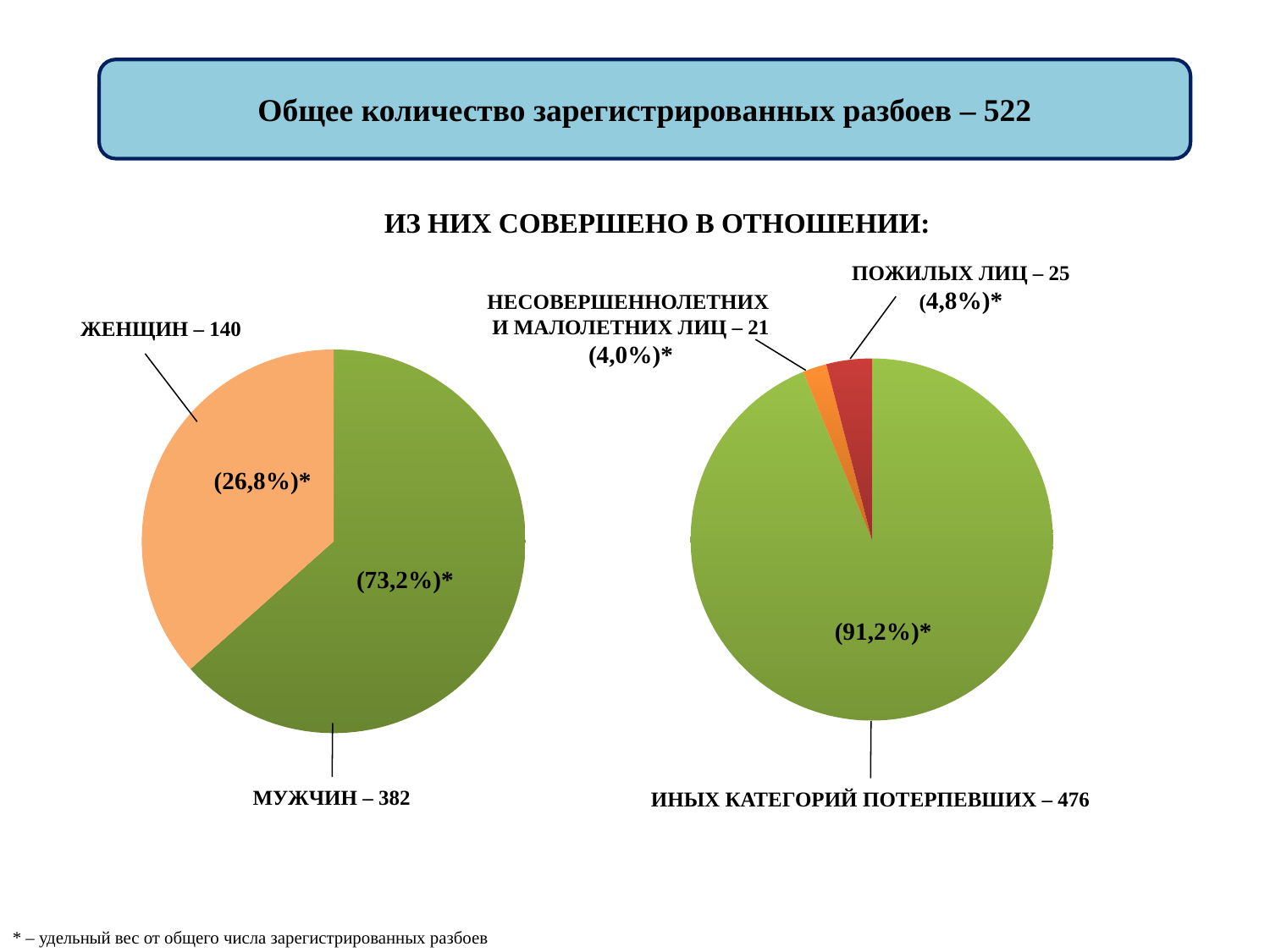
On the right pie chart, what is the value for НЕСОВЕРШЕННОЛЕТНИХ И МАЛОЛЕТНИХ ЛИЦ? 21 How many slices does the right pie chart have? 3 On the right pie chart, which category has the smallest value? НЕСОВЕРШЕННОЛЕТНИХ И МАЛОЛЕТНИХ ЛИЦ What type of chart is the left chart? Pie chart On the left pie chart, what is the value for ЖЕНЩИН? 140 On the right pie chart, what share of the pie does the ИНЫХ КАТЕГОРИЙ ПОТЕРПЕВШИХ slice represent? 91,2% On the left pie chart, what share of the pie does the МУЖЧИН slice represent? 73,2% On the left pie chart, what is the difference between the values for МУЖЧИН and ЖЕНЩИН? 242 On the right pie chart, what is the value for ПОЖИЛЫХ ЛИЦ? 25 On the right pie chart, which category has the largest value? ИНЫХ КАТЕГОРИЙ ПОТЕРПЕВШИХ On the left pie chart, what is the value for МУЖЧИН? 382 On the left pie chart, what share of the pie does the ЖЕНЩИН slice represent? 26,8%